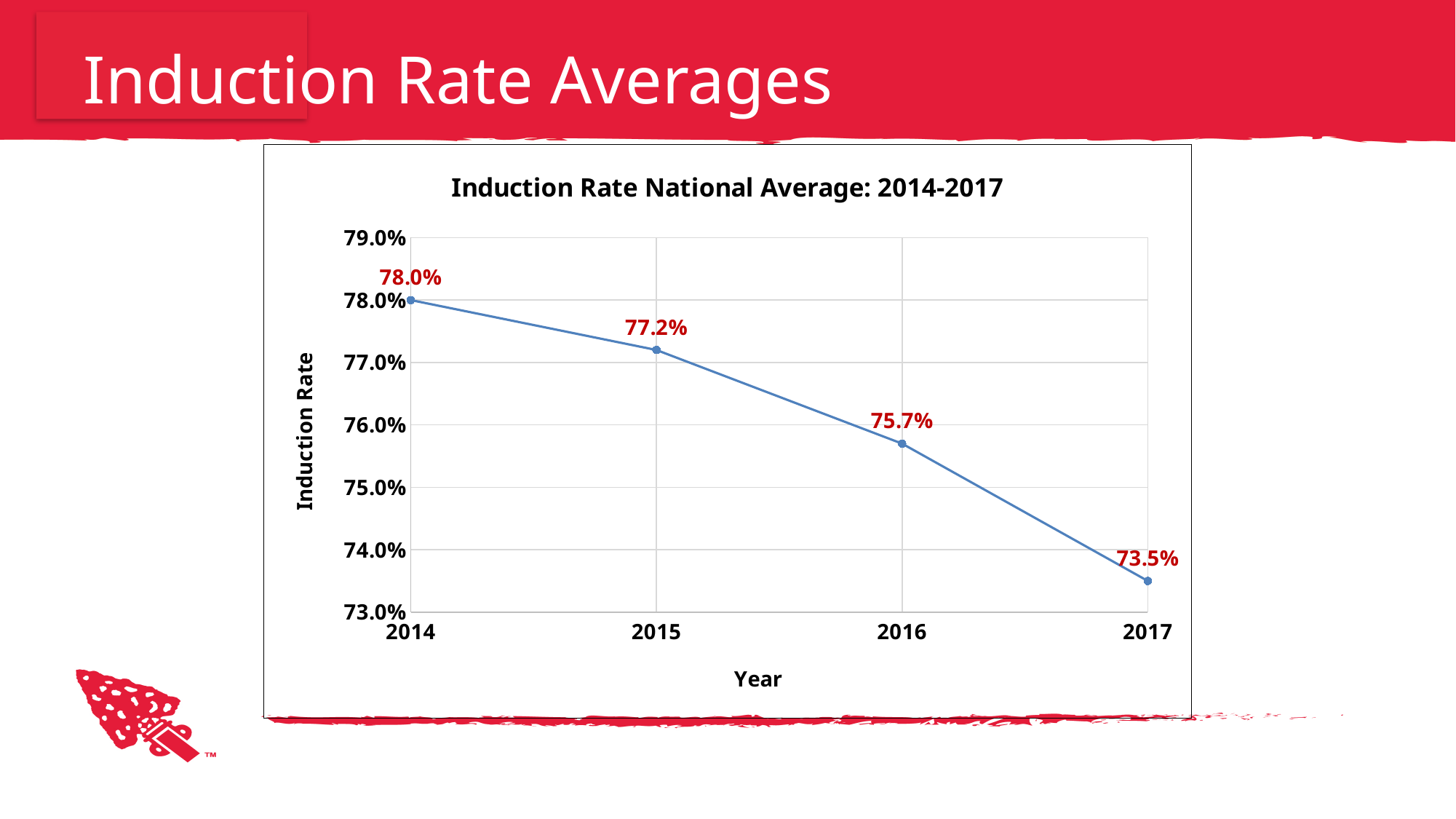
What was the induction rate national average in 2014? 78.0% What kind of chart is shown on the slide? Line chart What is the difference between the 2015 and 2016 induction rates? 1.5 percentage points What was the induction rate national average in 2017? 73.5% Which year had a higher induction rate, 2015 or 2016? 2015 Does the induction rate rise or fall from 2014 to 2017? Fall How many years are plotted on the chart? 4 Which year had the highest induction rate? 2014 What was the induction rate national average in 2016? 75.7% Is the induction rate for 2017 greater or less than 74.0%? less By how many percentage points did the induction rate fall from 2014 to 2017? 4.5 percentage points Which year had the lowest induction rate? 2017